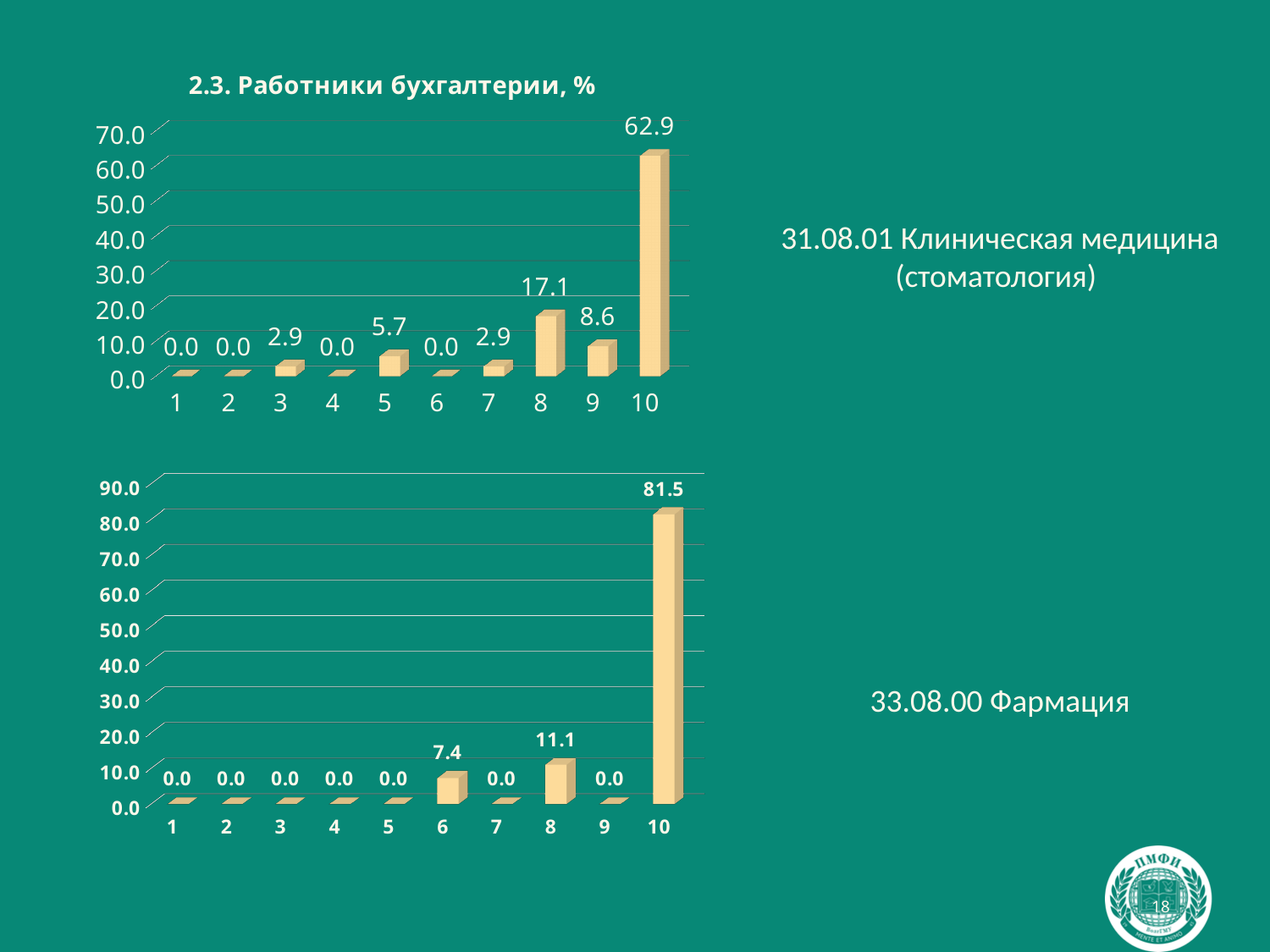
In the bottom chart, what is the value for category 6? 7.4 In the top chart, how many categories are shown on the x axis? 10 In the top chart, what is the value for category 8? 17.1 In the bottom chart, what is the value for category 10? 81.5 In the bottom chart, what is the difference between the values for categories 8 and 6? 3.7 In the top chart, which is larger, the value for category 5 or the value for category 3? category 5 What type of chart is the bottom chart? bar chart In the top chart, what is the value for category 10? 62.9 In the top chart, which category has the highest value? 10 In the top chart, what is the value for category 9? 8.6 What is the title of the top chart? 2.3. Работники бухгалтерии, % In the top chart, what is the difference between the values for categories 8 and 9? 8.5